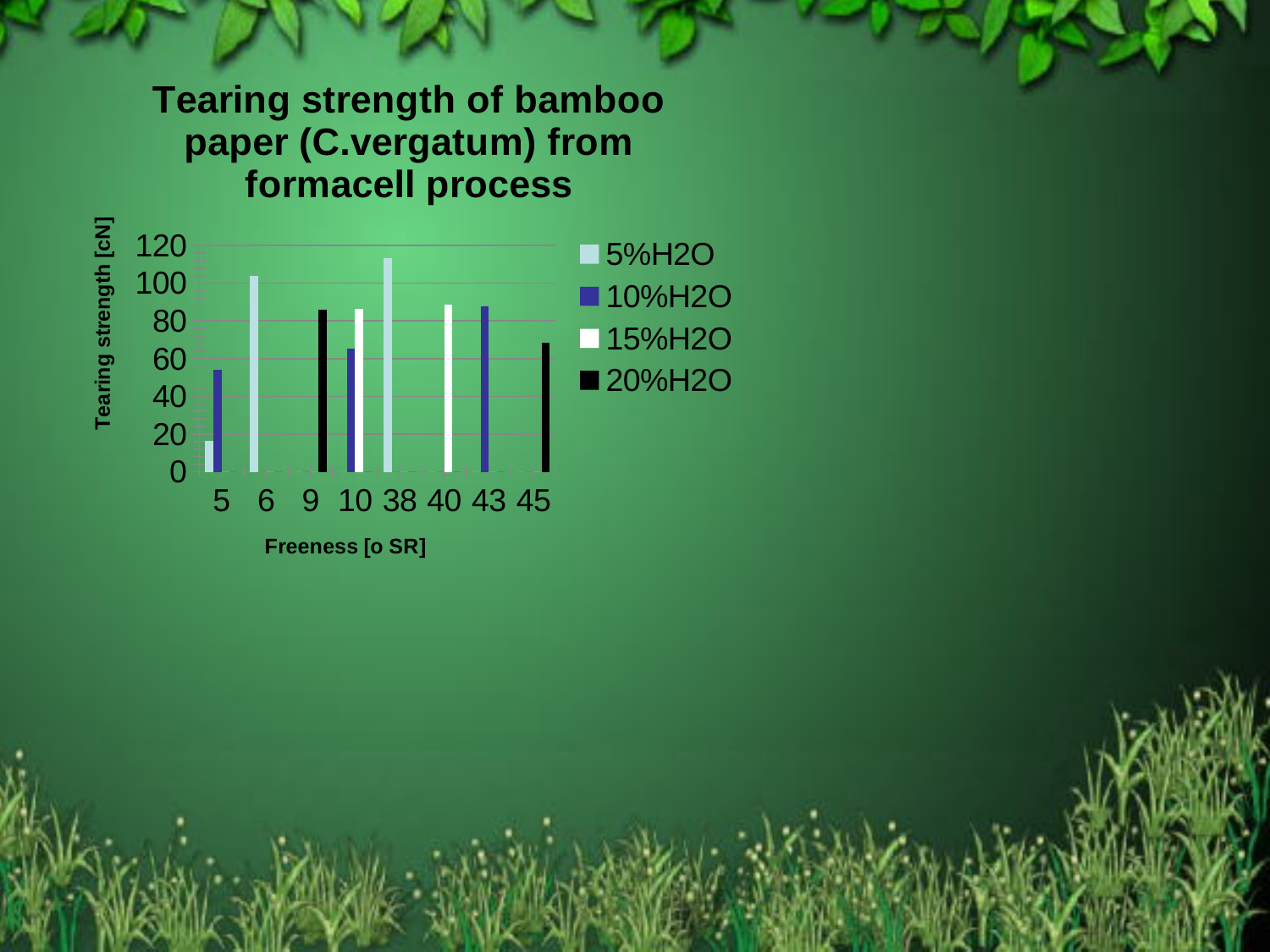
Is the 20%H2O value at freeness 9 greater or less than 60? greater At which freeness value does the tallest bar in the chart appear? 38 At which freeness value does the shortest bar in the chart appear? 5 How many freeness categories are shown on the x axis? 8 At freeness 10, which series has the larger tearing strength, 10%H2O or 15%H2O? 15%H2O What kind of chart is shown on the slide? bar chart Is the 20%H2O value at freeness 45 greater or less than 80? less Is the 5%H2O value at freeness 5 greater or less than 40? less For the 20%H2O series, which freeness has the larger tearing strength, 9 or 45? 9 How many series does the legend list? 4 What is the title of the vertical axis? Tearing strength [cN]